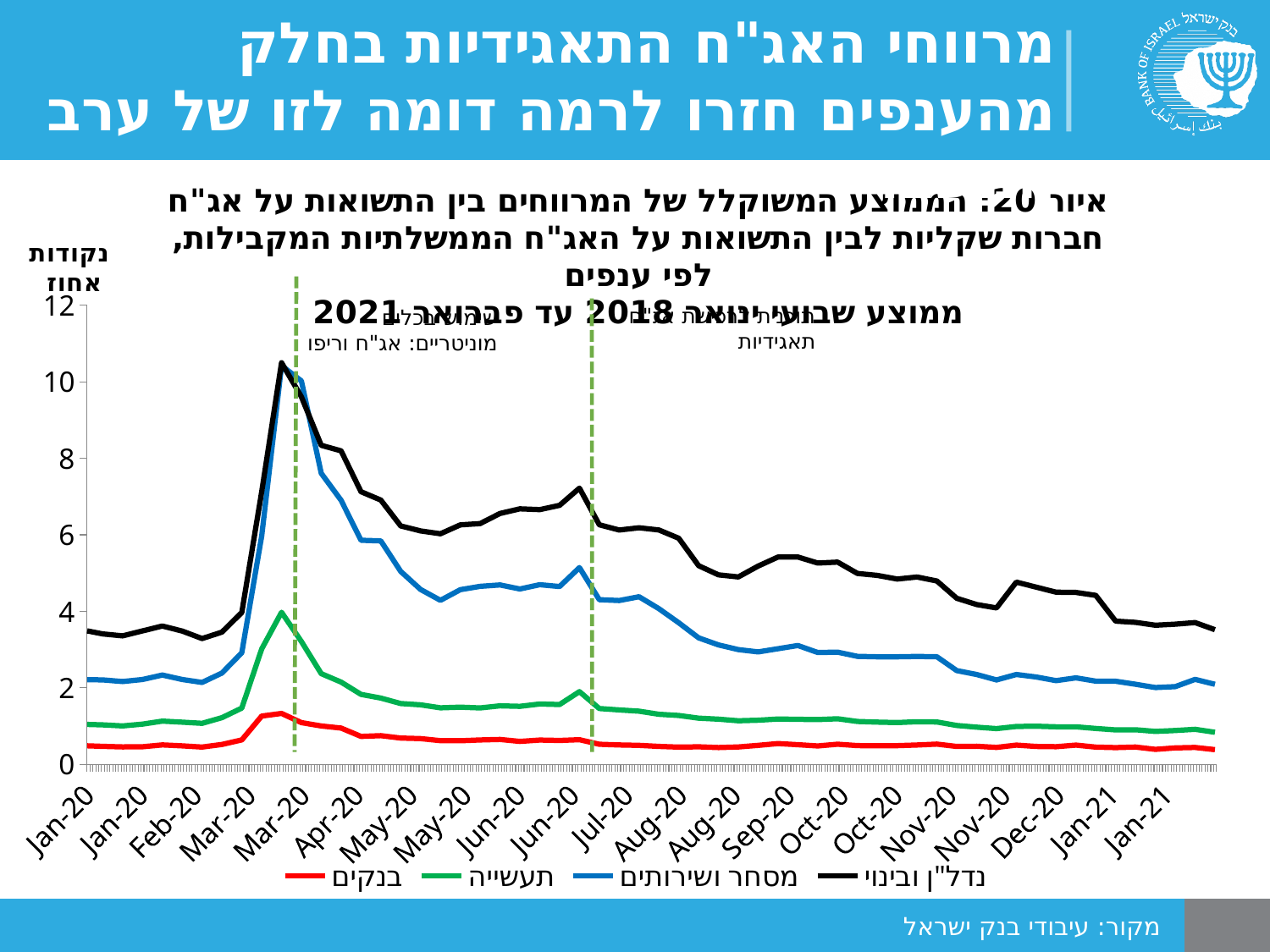
What is the label on the vertical axis? נקודות אחוז Which series has the lowest values across the whole period? בנקים Which series has the highest values across the whole period? נדל"ן ובינוי Is the peak value of בנקים in Mar-20 greater or less than 2? less Is the value of נדל"ן ובינוי at the end of the period (Jan-21) greater or less than 2? greater Is the peak value of תעשייה in Mar-20 greater or less than 6? less How many series does the legend list? 4 What colour is the line for בנקים? red Do the values of נדל"ן ובינוי rise or fall from the Mar-20 peak to Jan-21? fall At Jan-21, which is larger: מסחר ושירותים or תעשייה? מסחר ושירותים What kind of chart is shown on the slide? line chart